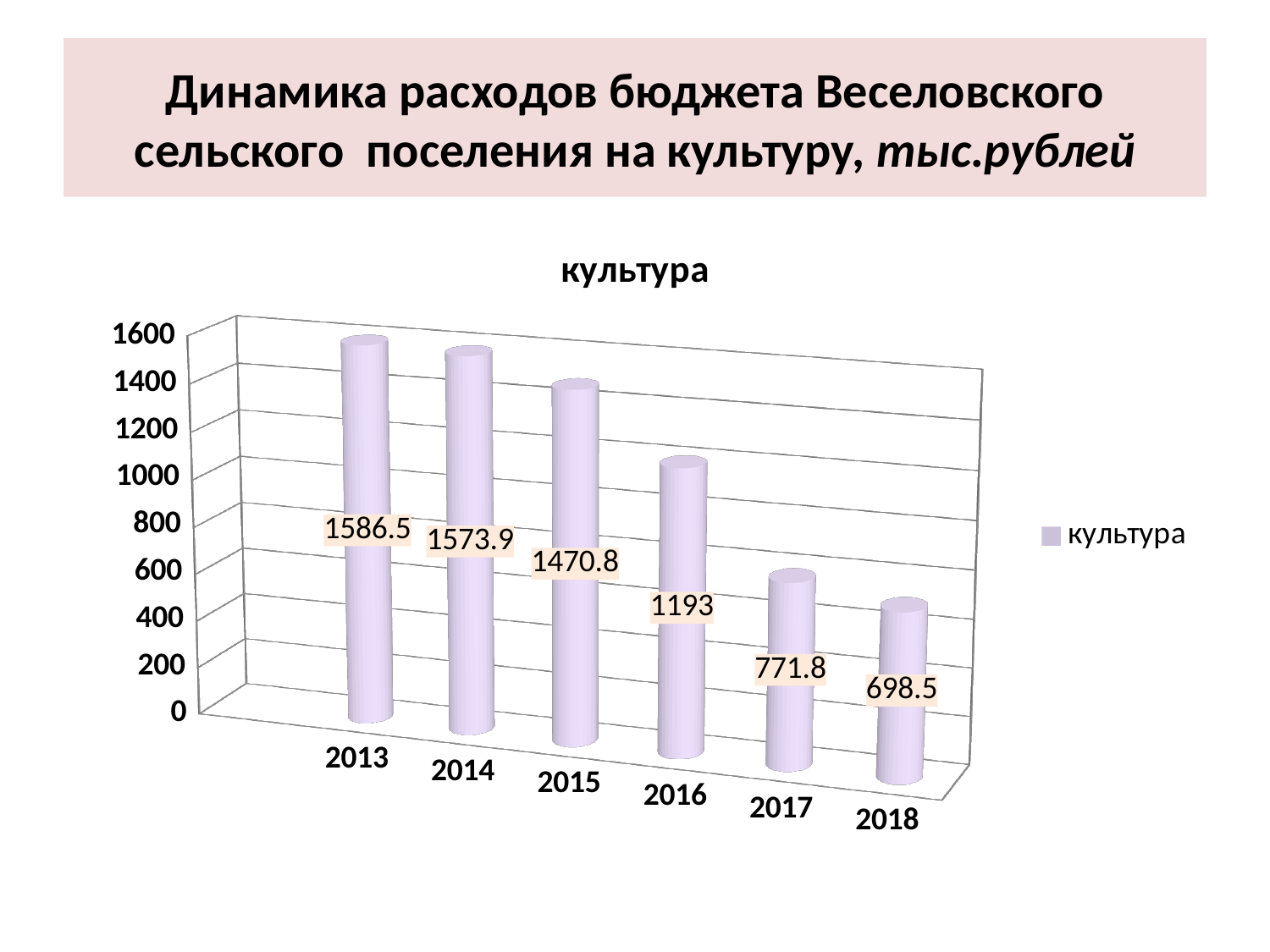
What is the difference between the values for 2015 and 2016? 277.8 What kind of chart is shown? bar chart What is the value for 2016? 1193 How many series does the legend list? 1 Do the values rise or fall from 2013 to 2018? fall Which year has the lowest value? 2018 How many years are shown on the chart? 6 Which is larger, the value for 2014 or the value for 2015? 2014 Which year has the highest value? 2013 What is the value for 2018? 698.5 What is the difference between the values for 2017 and 2018? 73.3 What is the value for 2013? 1586.5